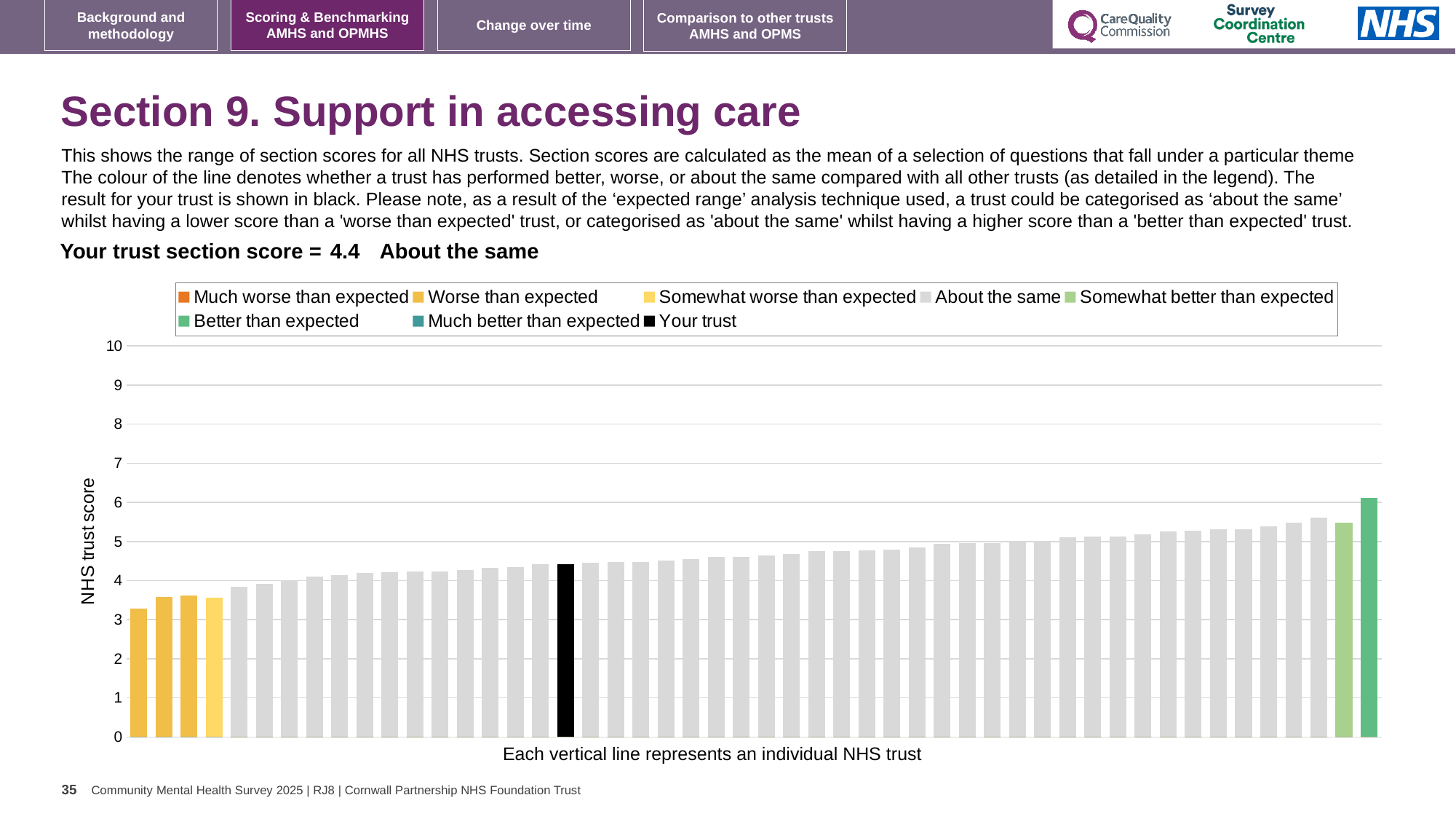
Is the value of the black 'Your trust' bar greater or less than 4? greater Which is higher: the black 'Your trust' bar or the rightmost green bar? the rightmost green bar What is the section score for your trust shown on the slide? 4.4 Do the bar values rise or fall from left to right along the x axis? rise Is the value of the leftmost bar greater or less than 4? less How many entries does the chart legend list? 8 Which legend category do the lowest bars in the chart belong to? Worse than expected What kind of chart is shown on the slide? bar chart Is the value of the black 'Your trust' bar greater or less than 5? less Which performance category is your trust placed in for this section? About the same Which legend category does the tallest bar in the chart belong to? Better than expected